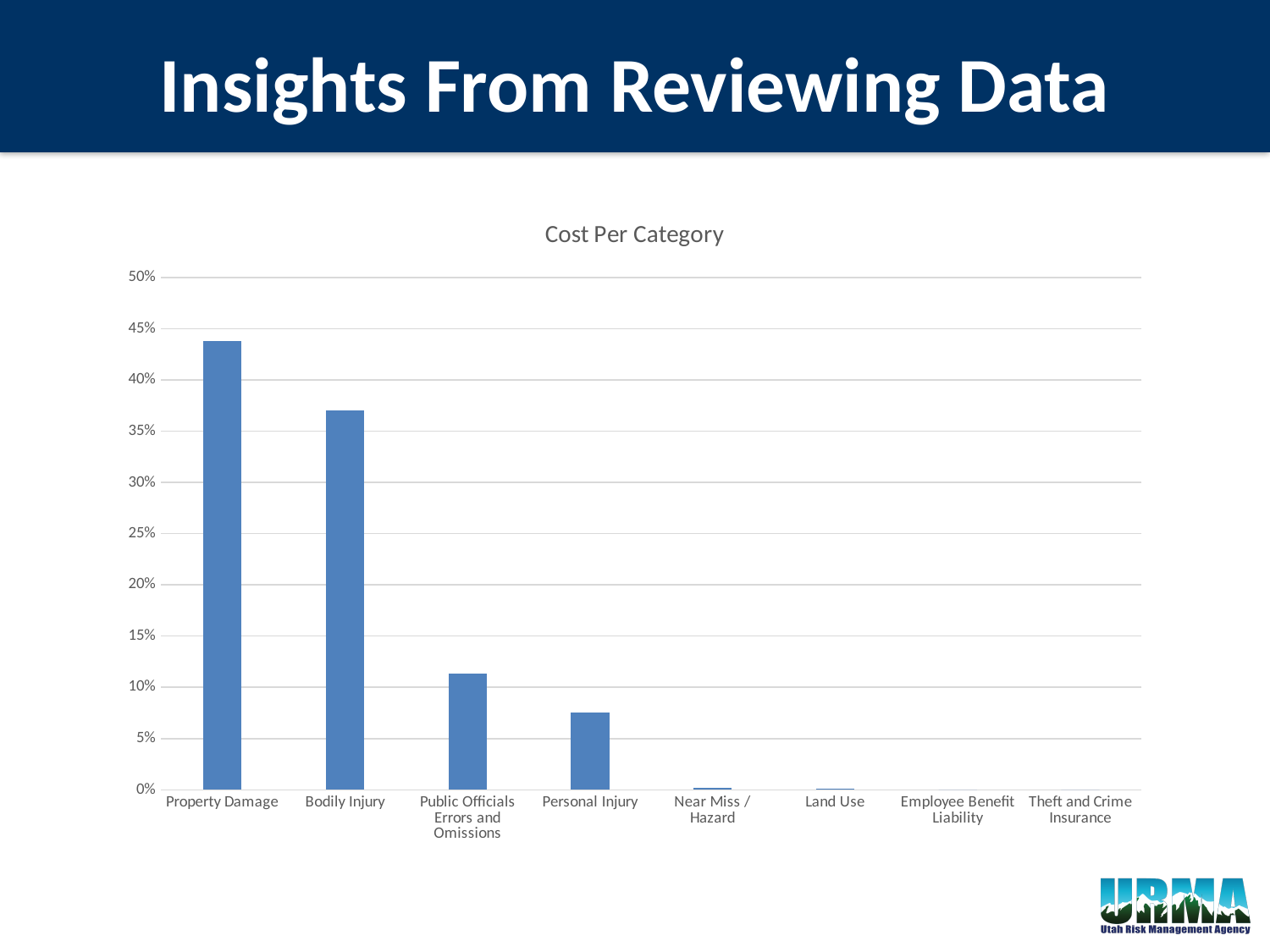
How many categories are shown on the x axis of the chart? 8 Is the value for Public Officials Errors and Omissions greater or less than 10%? greater Is the value for Bodily Injury greater or less than 40%? less Do the values generally rise or fall moving from left to right along the x axis? fall What is the title of the chart? Cost Per Category What kind of chart is shown on the slide? bar chart Is the value for Property Damage greater or less than 40%? greater Which is larger, the value for Bodily Injury or the value for Personal Injury? Bodily Injury Which category has the highest value in the chart? Property Damage Which is larger, the value for Public Officials Errors and Omissions or the value for Near Miss / Hazard? Public Officials Errors and Omissions